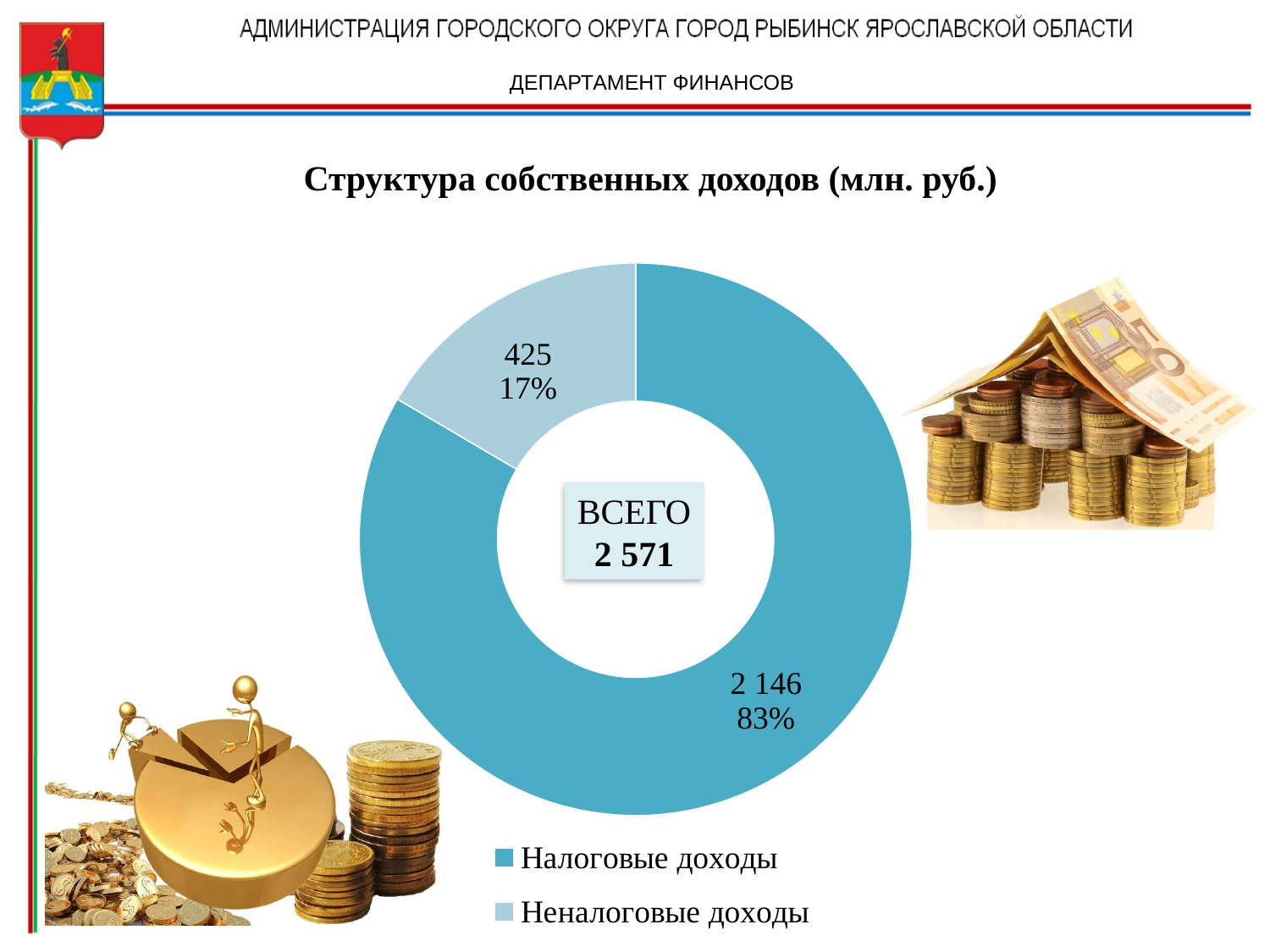
What is the title of the chart? Структура собственных доходов (млн. руб.) Which category has the smallest slice? Неналоговые доходы Which is larger, Налоговые доходы or Неналоговые доходы? Налоговые доходы What kind of chart is shown on the slide? Pie chart (doughnut) What share of the pie does Налоговые доходы take? 83% Which category has the largest slice? Налоговые доходы What total (ВСЕГО) is shown in the centre of the chart? 2 571 How many categories does the pie chart have? 2 What is the value for Налоговые доходы? 2 146 What is the difference between Налоговые доходы and Неналоговые доходы? 1 721 What is the value for Неналоговые доходы? 425 What share of the pie does Неналоговые доходы take? 17%